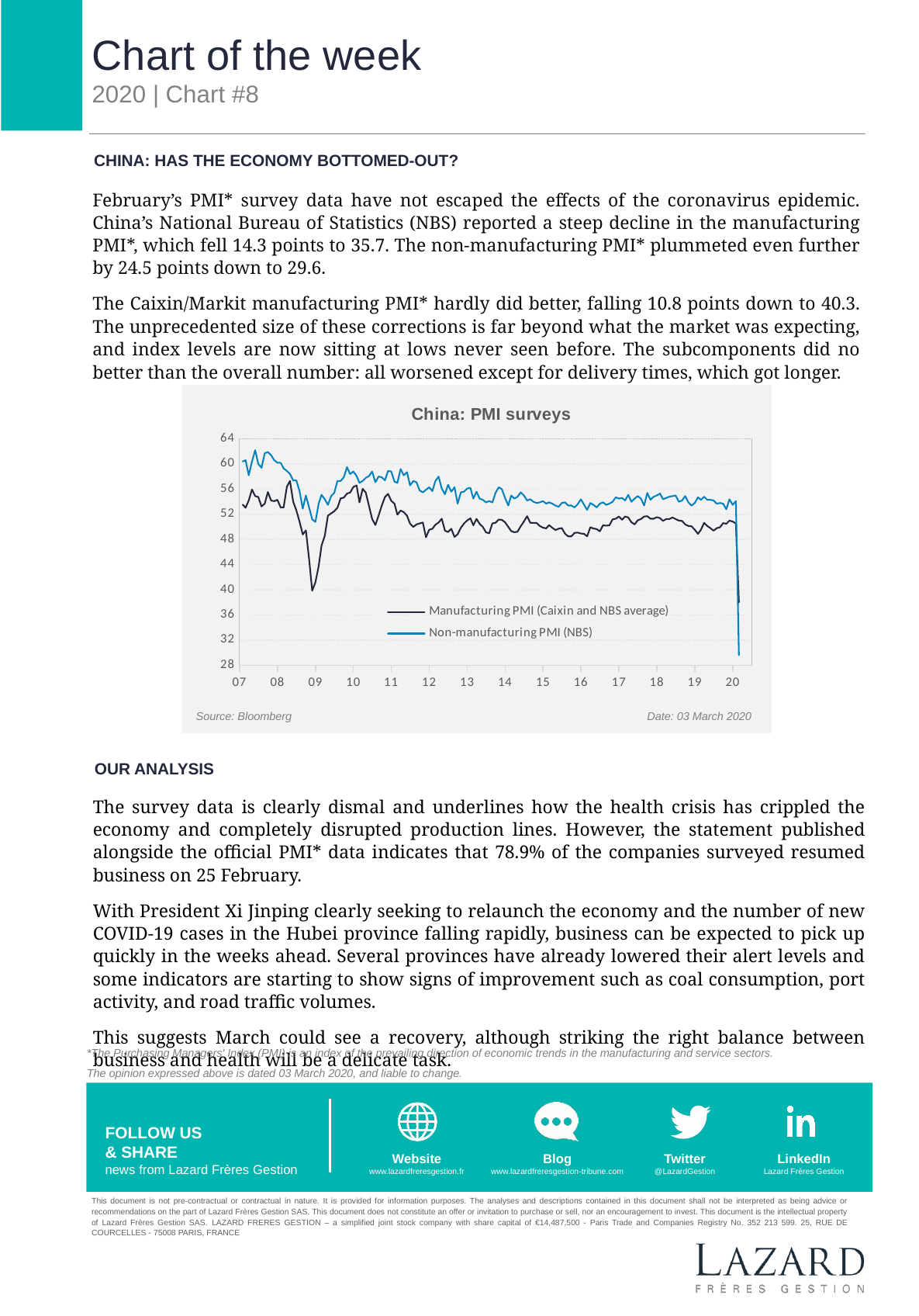
Is the Non-manufacturing PMI (NBS) value at the start of 2007 greater or less than 56? greater What is the title of the chart? China: PMI surveys Which series sits higher for most of the period from 2007 to 2019, Manufacturing PMI or Non-manufacturing PMI? Non-manufacturing PMI (NBS) Does the Non-manufacturing PMI (NBS) line generally rise or fall between 2007 and 2019? fall How many year labels are shown on the x axis of the chart? 14 Which two series are listed in the chart's legend? Manufacturing PMI (Caixin and NBS average) and Non-manufacturing PMI (NBS) What kind of chart is shown on the slide? Line chart Is the final 2020 value of the Manufacturing PMI (Caixin and NBS average) line greater or less than 40? less Is the final 2020 value of the Non-manufacturing PMI (NBS) line greater or less than 32? less Which series falls to the lower value at the end of the chart in 2020? Non-manufacturing PMI (NBS) How many series does the legend of the chart list? 2